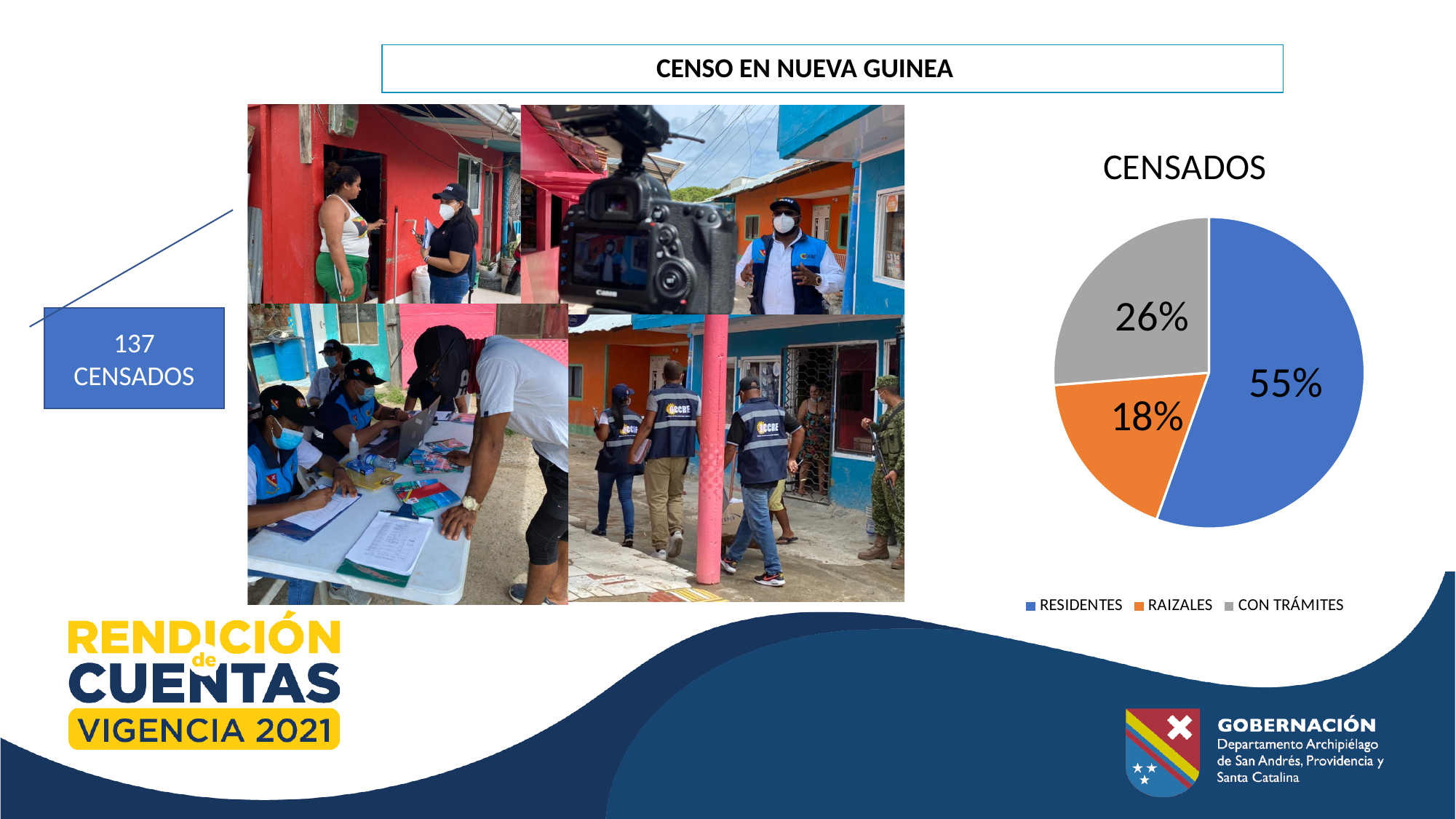
What share of the pie does RESIDENTES represent? 55% How many categories does the pie chart show? 3 What type of chart is shown on the slide? pie chart Which category has the smallest slice of the pie? RAIZALES What is the difference in percentage points between CON TRÁMITES and RAIZALES? 8% Which is larger, the share for CON TRÁMITES or the share for RAIZALES? CON TRÁMITES What share of the pie does RAIZALES represent? 18% What is the title of the pie chart? CENSADOS What share of the pie does CON TRÁMITES represent? 26% Which category has the largest slice of the pie? RESIDENTES What colour is the RAIZALES slice in the pie chart? orange What is the difference in percentage points between RESIDENTES and CON TRÁMITES? 29%